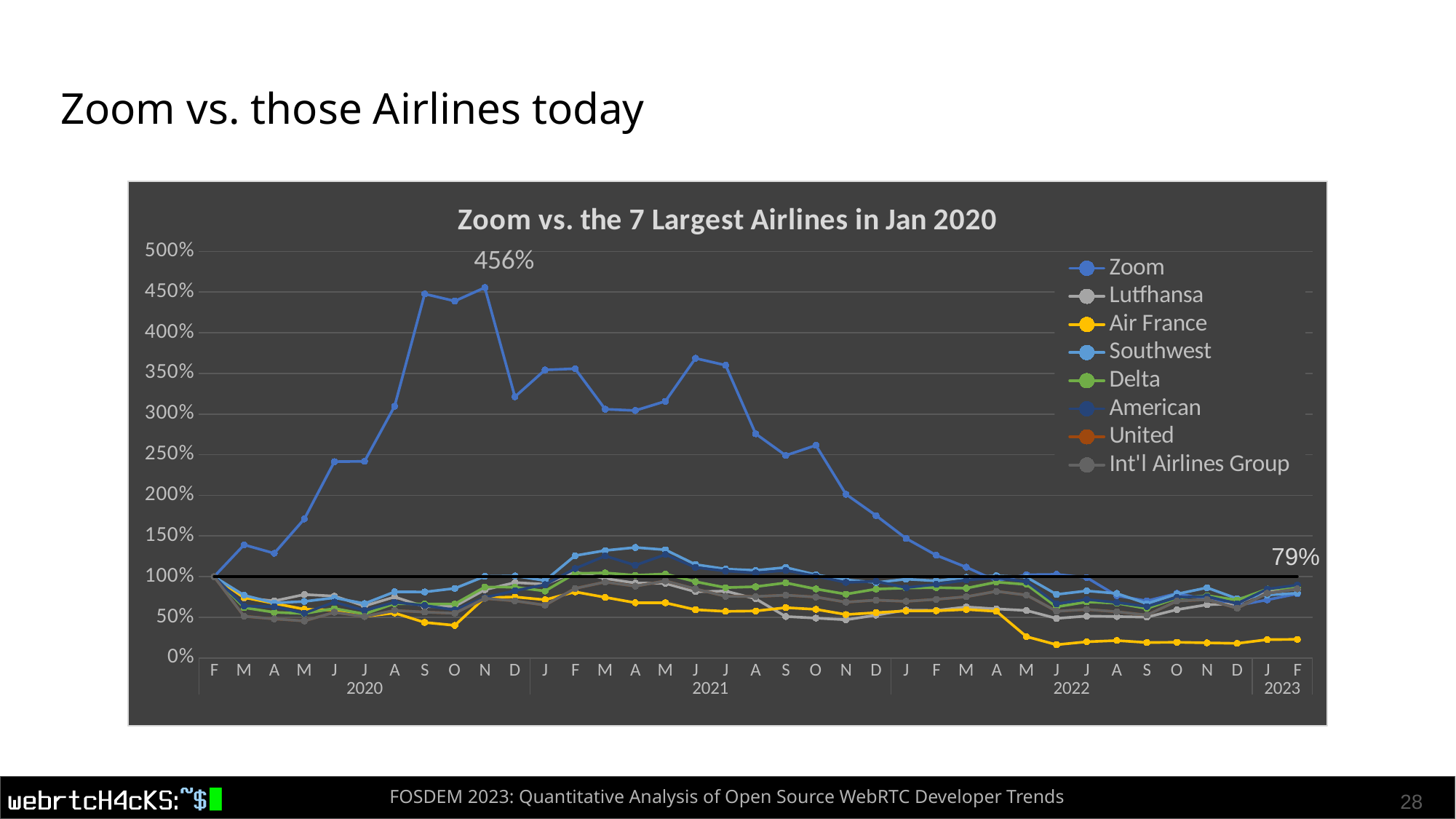
Which series has the lowest value in February 2023? Air France What kind of chart is shown on the slide? line chart Is the value for Air France in February 2023 greater or less than 50%? less Which is larger in February 2023, the value for Zoom or the value for Air France? Zoom Which series reaches the highest value on the chart? Zoom What is the difference between Zoom's labelled peak of 456% and its labelled February 2023 value of 79%? 377% What value is labelled at the end of the Zoom line in February 2023? 79% Does the Zoom line rise or fall from November 2020 to February 2023? fall Is the value for Zoom in November 2020 greater or less than 400%? greater How many series does the legend list? 8 What is the title of the chart? Zoom vs. the 7 Largest Airlines in Jan 2020 What is the peak value labelled on the Zoom line? 456%